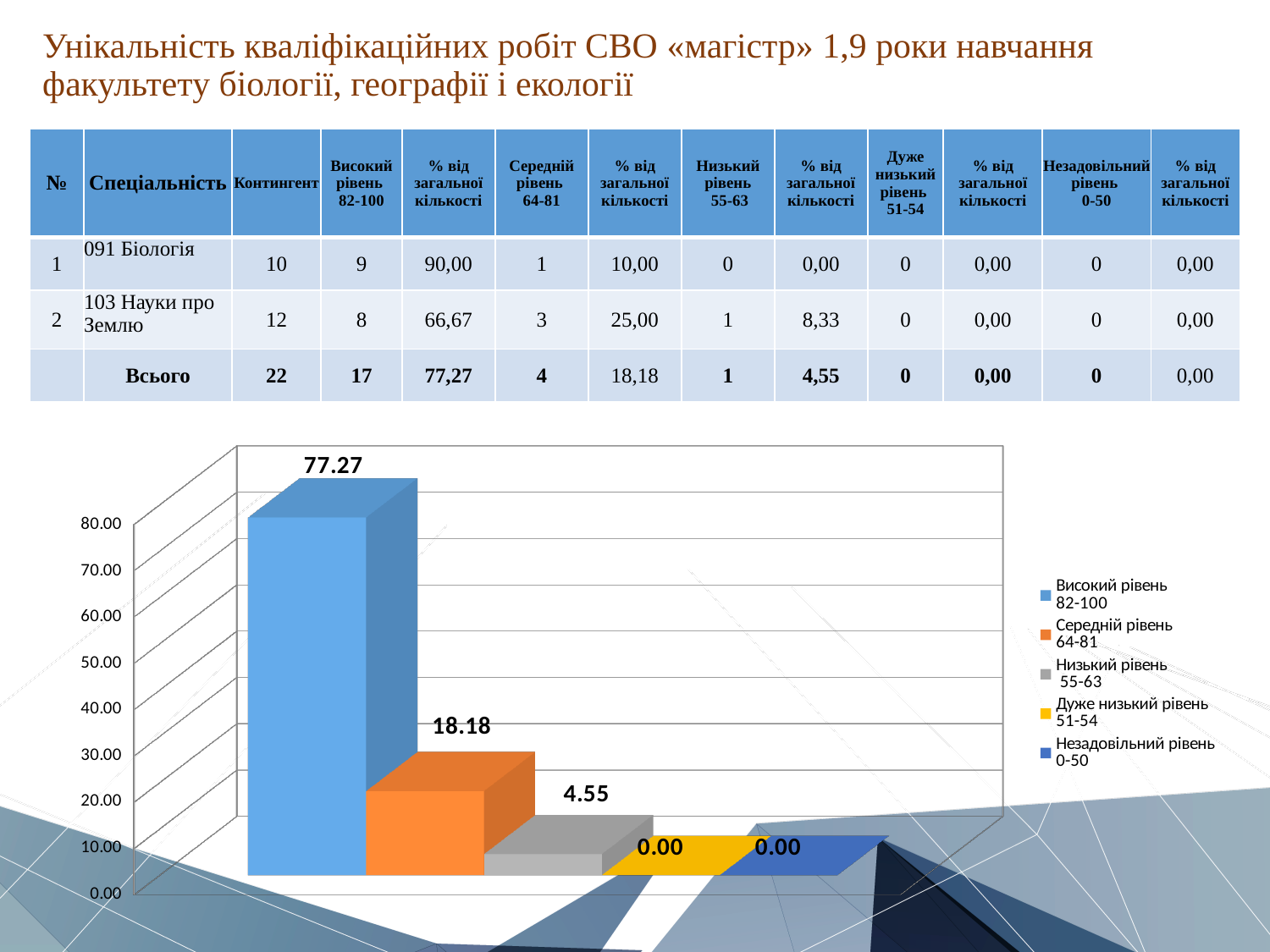
Which is larger, the value for Середній рівень 64-81 or the value for Низький рівень 55-63? Середній рівень 64-81 What is the difference between the values for Високий рівень 82-100 and Середній рівень 64-81? 59.09 How many series does the chart legend list? 5 What is the value shown for Низький рівень 55-63 in the chart? 4.55 What is the difference between the values for Середній рівень 64-81 and Низький рівень 55-63? 13.63 Which series has the highest value in the chart? Високий рівень 82-100 What is the value shown for Високий рівень 82-100 in the chart? 77.27 What is the value shown for Середній рівень 64-81 in the chart? 18.18 What is the highest value labelled on the chart's vertical axis? 80.00 What kind of chart is shown on the slide? bar chart What is the value shown for Дуже низький рівень 51-54 in the chart? 0.00 Is the value for Високий рівень 82-100 greater or less than 70.00? greater